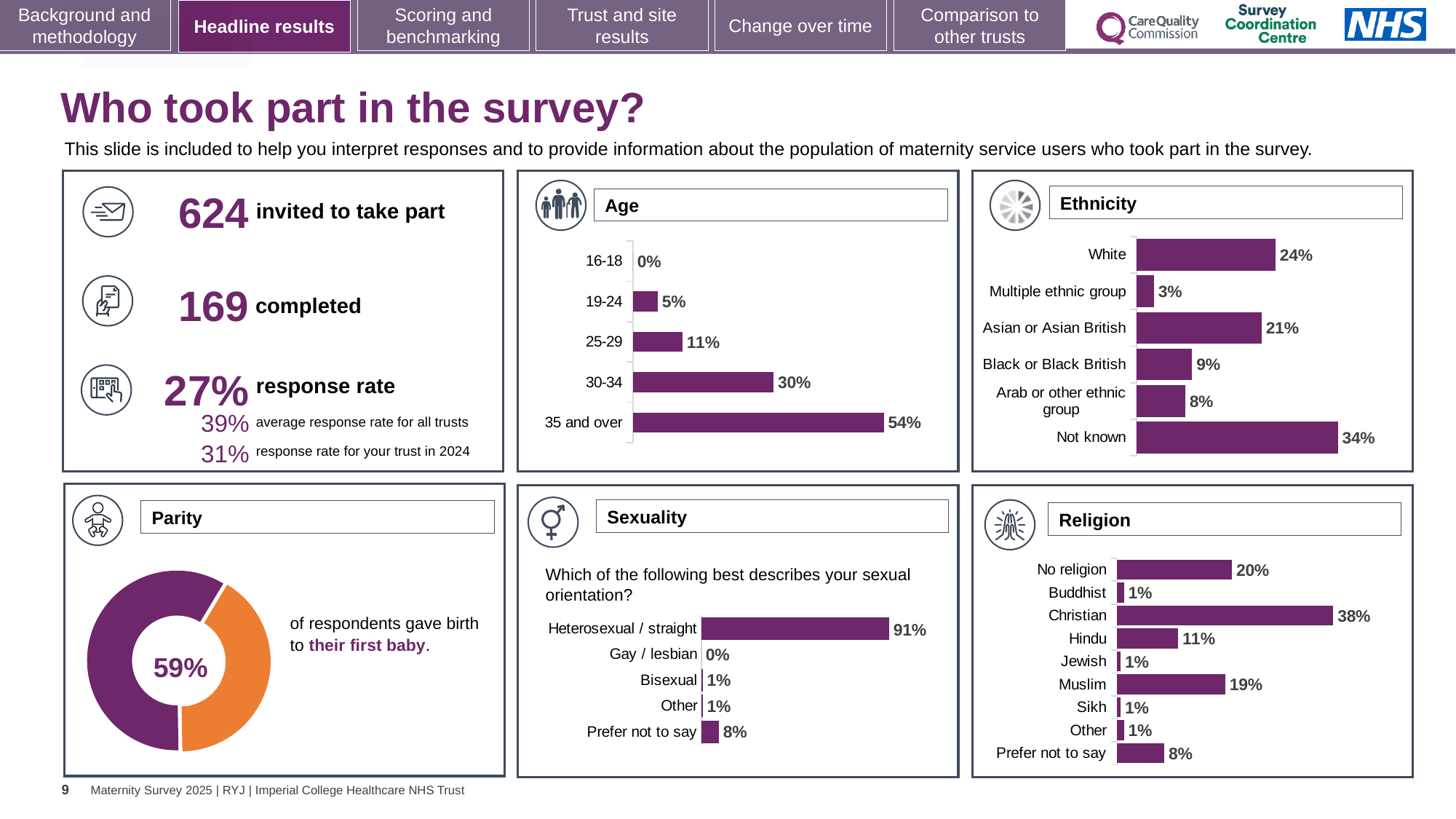
In the Age chart, what is the difference between the 30-34 and 25-29 percentages? 19% In the Religion chart, which category has the highest percentage? Christian In the Age chart, which age group has the lowest percentage? 16-18 In the Ethnicity chart, what percentage of respondents were Asian or Asian British? 21% In the Age chart, what percentage of respondents were aged 35 and over? 54% In the Sexuality chart, what percentage of respondents answered Heterosexual / straight? 91% In the Ethnicity chart, which is larger: White or Black or Black British? White What kind of chart is the Parity chart? Donut chart In the Ethnicity chart, which category has the highest percentage? Not known How many categories are shown in the Ethnicity chart? 6 In the Religion chart, what is the difference between the No religion and Muslim percentages? 1% In the Parity chart, what percentage of respondents gave birth to their first baby? 59%